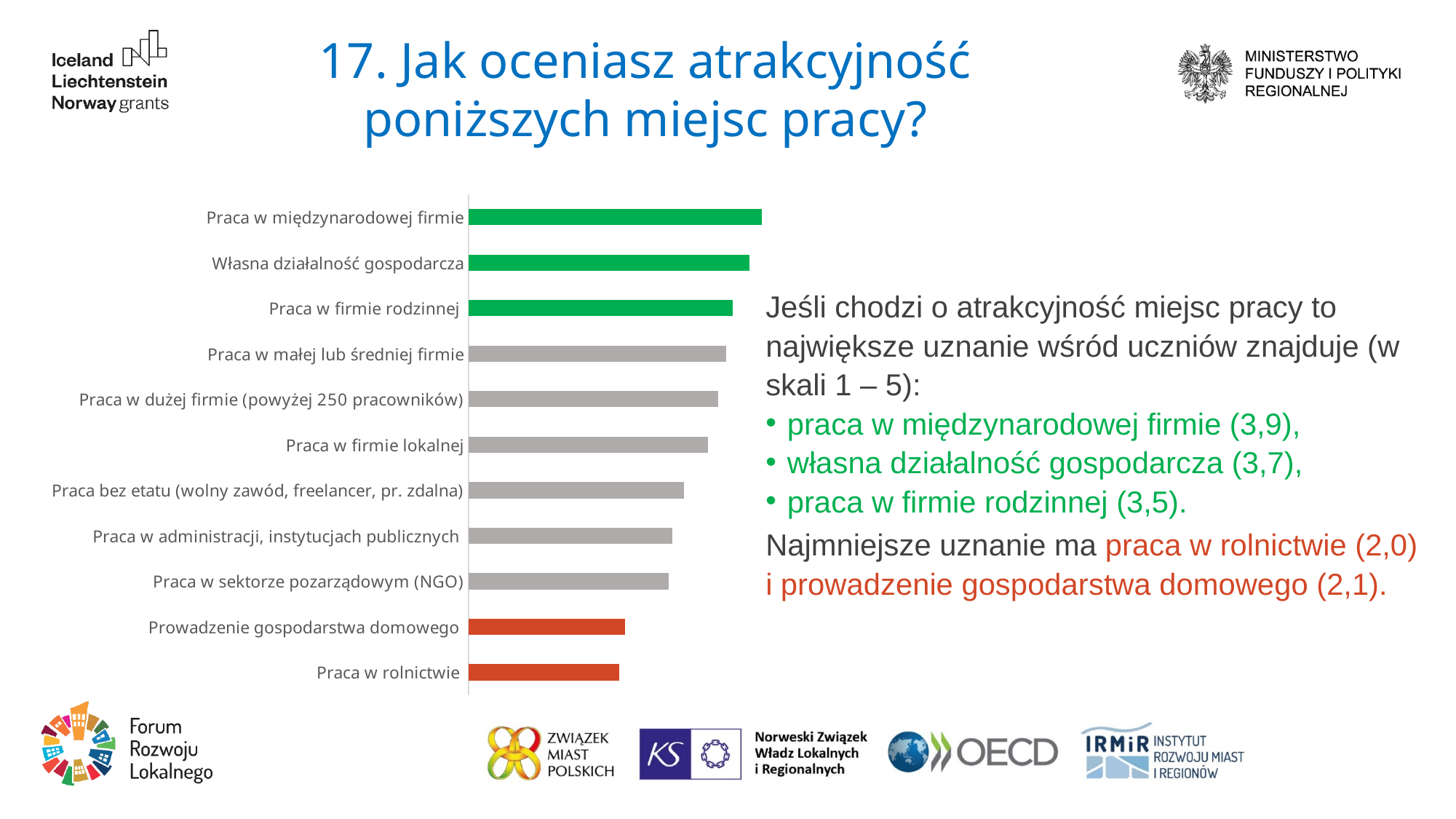
How many categories (job types) are plotted in the chart? 11 How many bars in the chart are coloured green? 3 What is the rating for 'Praca w międzynarodowej firmie'? 3,9 What is the rating for 'Praca w firmie rodzinnej'? 3,5 What is the rating for 'Własna działalność gospodarcza'? 3,7 What is the difference between the ratings for 'Praca w międzynarodowej firmie' and 'Praca w rolnictwie'? 1,9 What is the rating for 'Prowadzenie gospodarstwa domowego'? 2,1 Which has a larger value: 'Praca w małej lub średniej firmie' or 'Praca w sektorze pozarządowym (NGO)'? Praca w małej lub średniej firmie Which has a larger value: 'Praca w firmie lokalnej' or 'Prowadzenie gospodarstwa domowego'? Praca w firmie lokalnej Which category has the highest value in the chart? Praca w międzynarodowej firmie What kind of chart is shown on the slide? bar chart Which category has the lowest value in the chart? Praca w rolnictwie